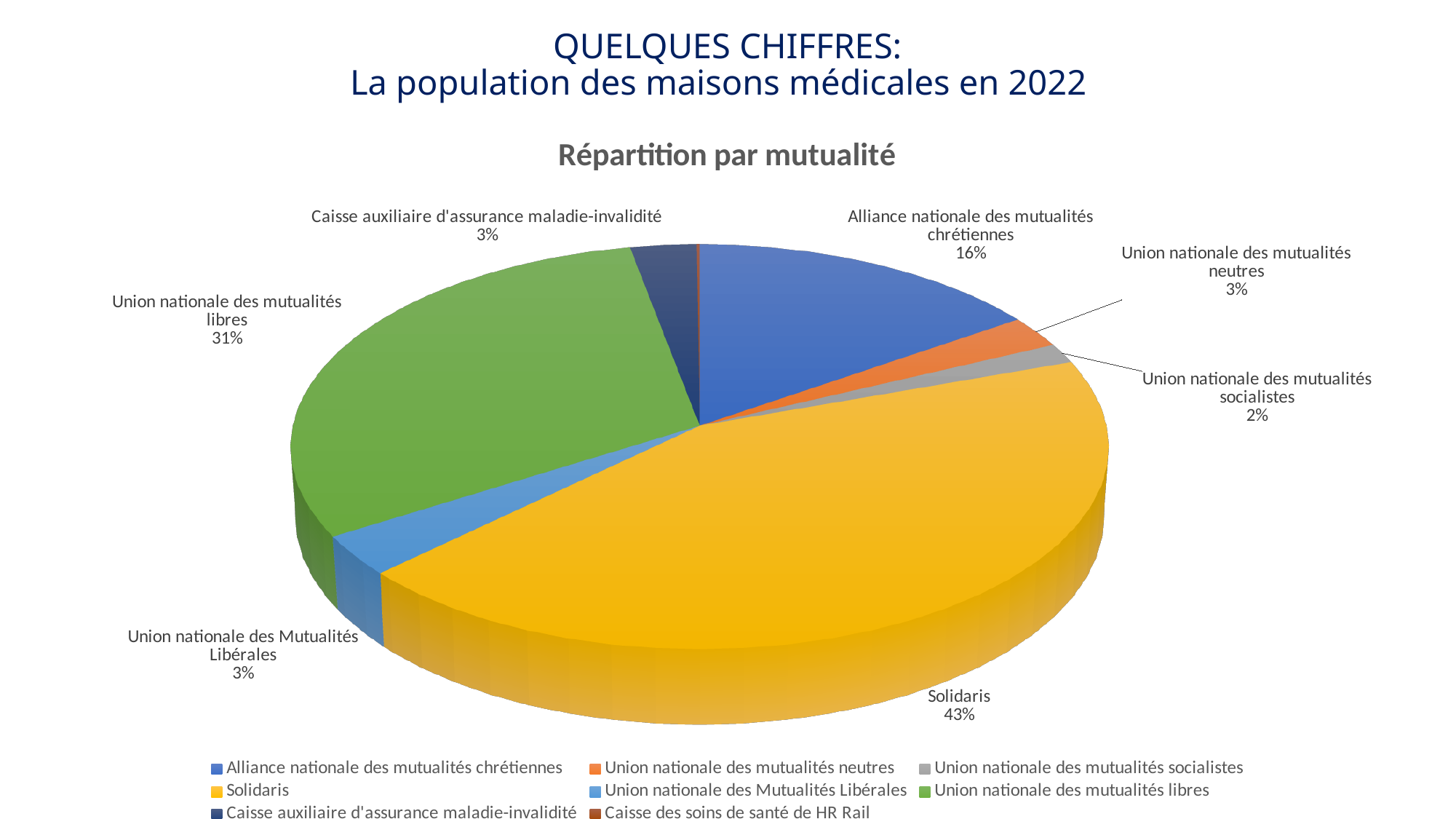
What kind of chart is shown on the slide? pie chart What is the value shown for Caisse auxiliaire d'assurance maladie-invalidité? 3% What is the value shown for Union nationale des mutualités socialistes? 2% What is the value shown for Union nationale des mutualités libres? 31% What share of the pie does Solidaris represent? 43% What is the difference in percentage points between Solidaris and Union nationale des mutualités libres? 12 percentage points Which is larger: the share for Union nationale des mutualités libres or for Alliance nationale des mutualités chrétiennes? Union nationale des mutualités libres Which category has the largest share of the pie? Solidaris How many categories does the legend list? 8 What is the value shown for Alliance nationale des mutualités chrétiennes? 16% What is the combined share of Solidaris and Union nationale des mutualités libres? 74% What is the title of the chart? Répartition par mutualité